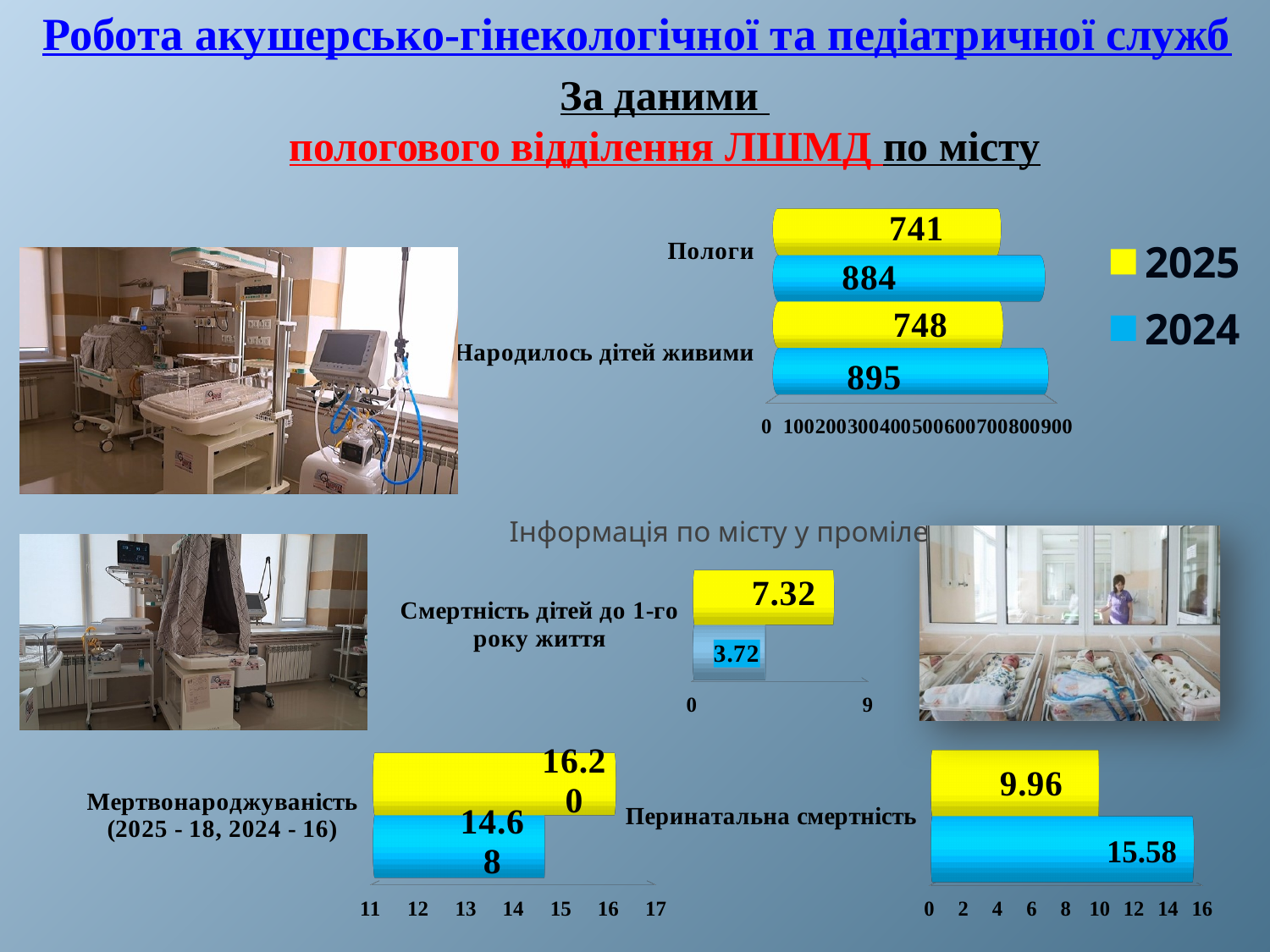
How many series does the legend of the top-right bar chart list? 2 In the top-right bar chart, what is the value for Народилось дітей живими in 2025? 748 In the top-right bar chart, what is the value for Пологи in 2024? 884 In the chart titled Перинатальна смертність, what is the value of the blue bar? 15.58 In the top-right bar chart, which year has the larger value for Народилось дітей живими, 2024 or 2025? 2024 In the top-right bar chart, what is the value for Народилось дітей живими in 2024? 895 In the chart titled Перинатальна смертність, what is the difference between the blue bar and the yellow bar? 5.62 In the chart titled Смертність дітей до 1-го року життя, what is the value of the blue bar? 3.72 In the top-right bar chart, which colour represents 2025? Yellow In the chart titled Смертність дітей до 1-го року життя, what is the value of the yellow bar? 7.32 In the top-right bar chart, what is the value for Пологи in 2025? 741 In the top-right bar chart, what is the difference between the 2024 and 2025 values for Пологи? 143